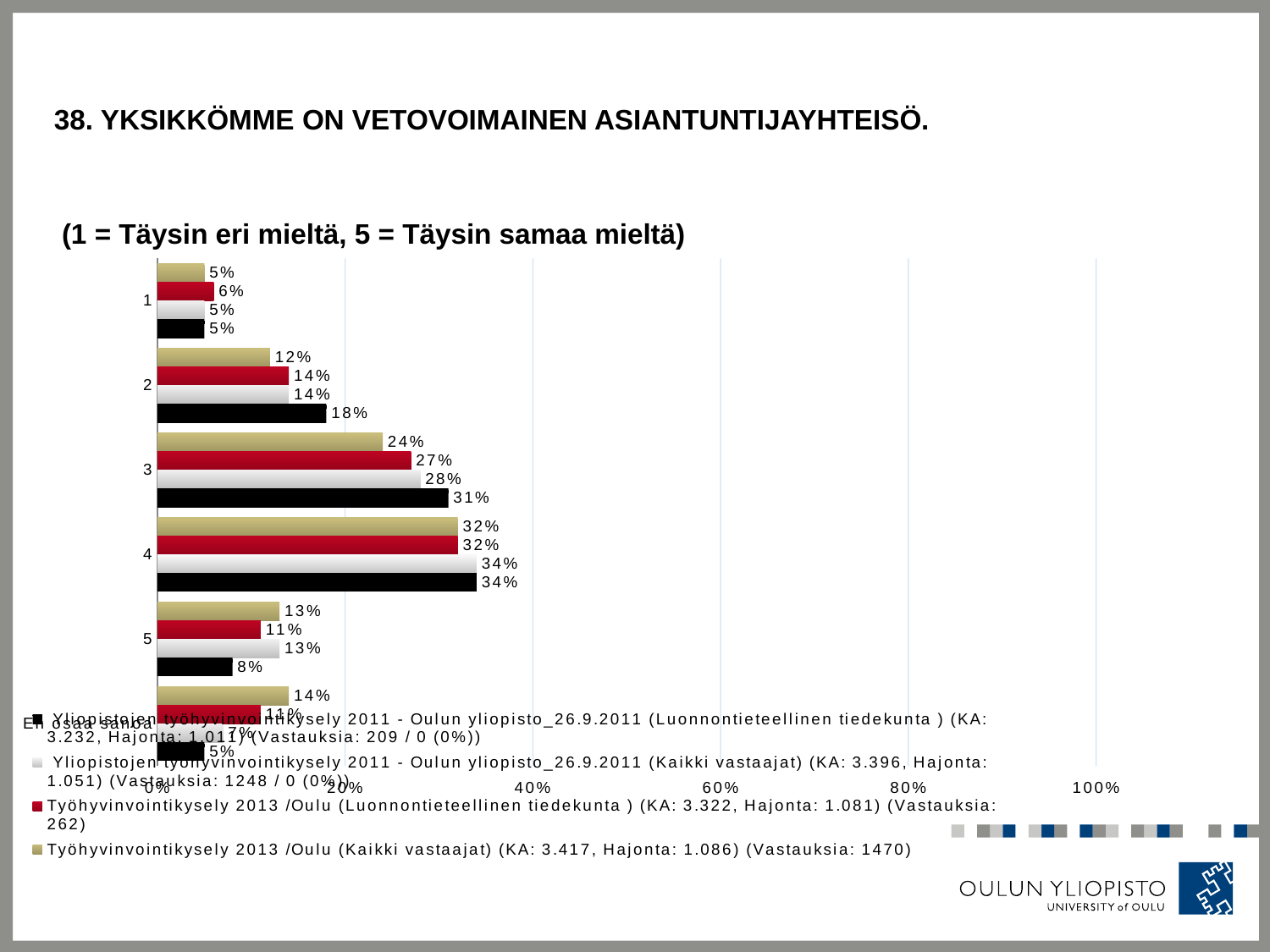
How many series does the legend list? 4 What is the difference between the values for category 3 and category 2 in the series Työhyvinvointikysely 2013 /Oulu (Kaikki vastaajat)? 12% What type of chart is shown on the slide? bar chart What is the value for category 2 in the series Työhyvinvointikysely 2013 /Oulu (Luonnontieteellinen tiedekunta)? 14% Is the value for category 4 in the series Yliopistojen työhyvinvointikysely 2011 - Oulun yliopisto (Kaikki vastaajat) greater or less than 40%? less What is the value for category 4 in the series Työhyvinvointikysely 2013 /Oulu (Kaikki vastaajat)? 32% Which category has the lowest value in the series Yliopistojen työhyvinvointikysely 2011 - Oulun yliopisto (Luonnontieteellinen tiedekunta)? 1 and En osaa sanoa (both 5%) What is the value for 'En osaa sanoa' in the series Työhyvinvointikysely 2013 /Oulu (Kaikki vastaajat)? 14% For category 5, which is larger: the value for Työhyvinvointikysely 2013 /Oulu (Kaikki vastaajat) or the value for Yliopistojen työhyvinvointikysely 2011 - Oulun yliopisto (Luonnontieteellinen tiedekunta)? Työhyvinvointikysely 2013 /Oulu (Kaikki vastaajat) How many categories are shown on the vertical axis of the chart? 6 Which category has the highest value in the series Yliopistojen työhyvinvointikysely 2011 - Oulun yliopisto (Kaikki vastaajat)? 4 What is the value for category 3 in the series Yliopistojen työhyvinvointikysely 2011 - Oulun yliopisto (Luonnontieteellinen tiedekunta)? 31%